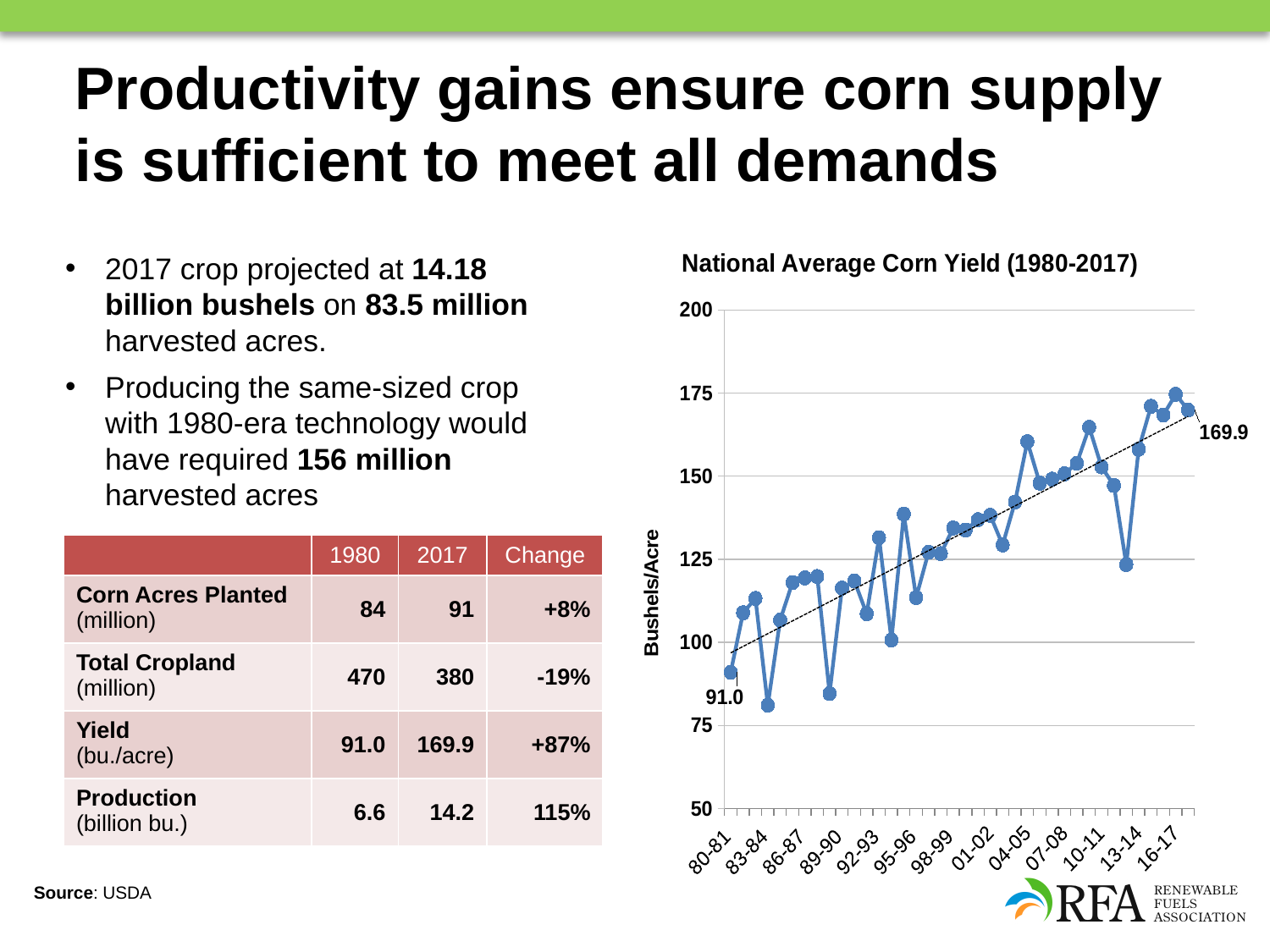
Is the value for 88-89 greater or less than 100? less What is the title of the chart? National Average Corn Yield (1980-2017) What is the label on the vertical axis of the chart? Bushels/Acre What is the highest value shown on the vertical axis of the chart? 200 Is the value for 83-84 greater or less than 100? less What is the corn yield value labeled for 80-81 on the chart? 91.0 What kind of chart is shown on the slide? line chart Overall, do corn yields rise or fall from 80-81 to 16-17 on the chart? rise Is the value for 04-05 greater or less than 150? greater Which is larger, the yield for 80-81 or the yield for 16-17? 16-17